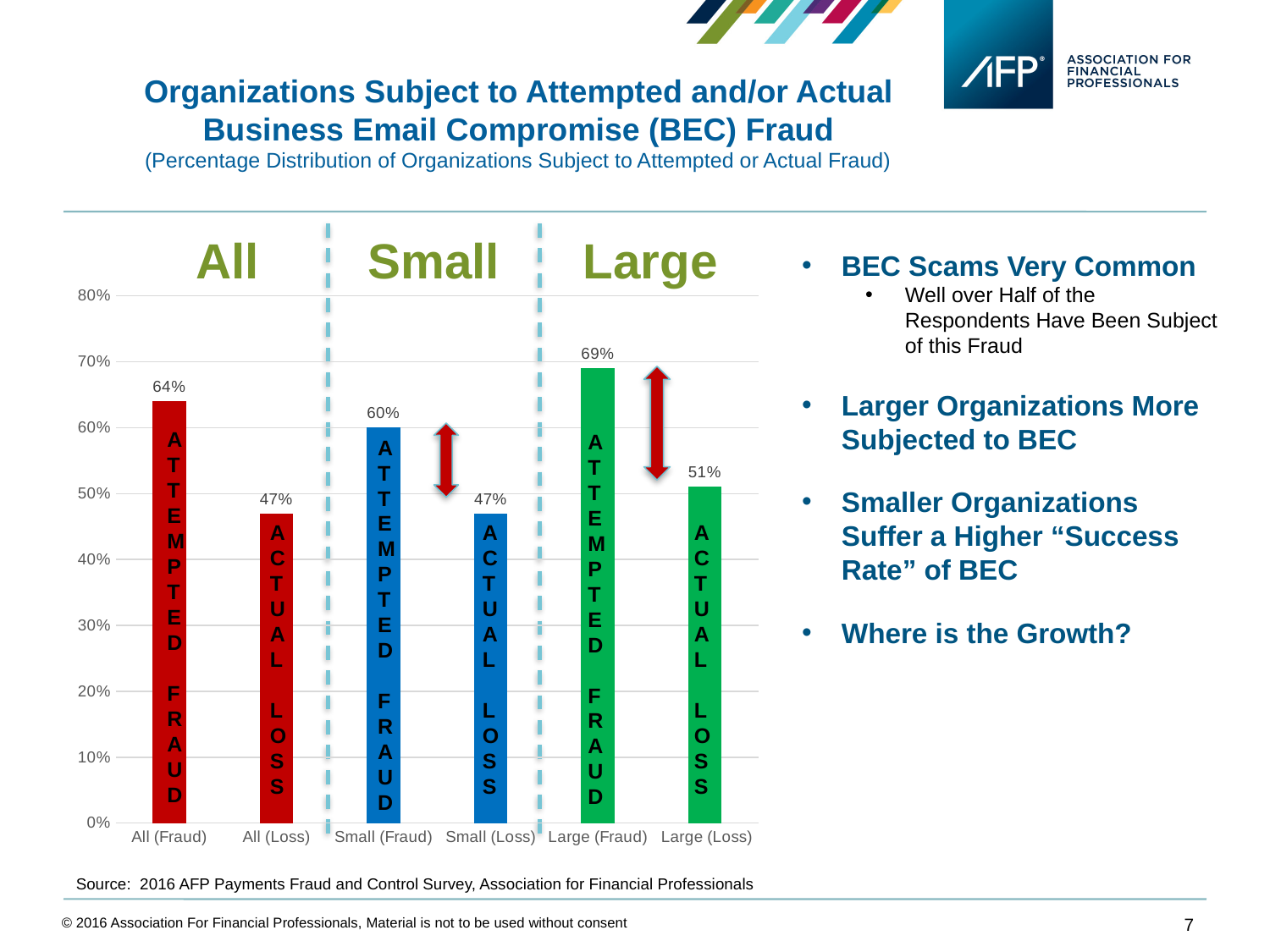
What is the difference between Large (Fraud) and Large (Loss)? 18% What is the value for All (Loss)? 47% What kind of chart is this? bar chart What is the value for All (Fraud)? 64% What is the value for Small (Fraud)? 60% Is the value for Large (Fraud) greater or less than 60%? greater How many categories are shown on the x axis? 6 What is the difference between Small (Fraud) and Small (Loss)? 13% Which category has the highest value? Large (Fraud) What colour are the bars for the Large group? green What is the value for Large (Loss)? 51% Which is larger, All (Fraud) or Small (Fraud)? All (Fraud)